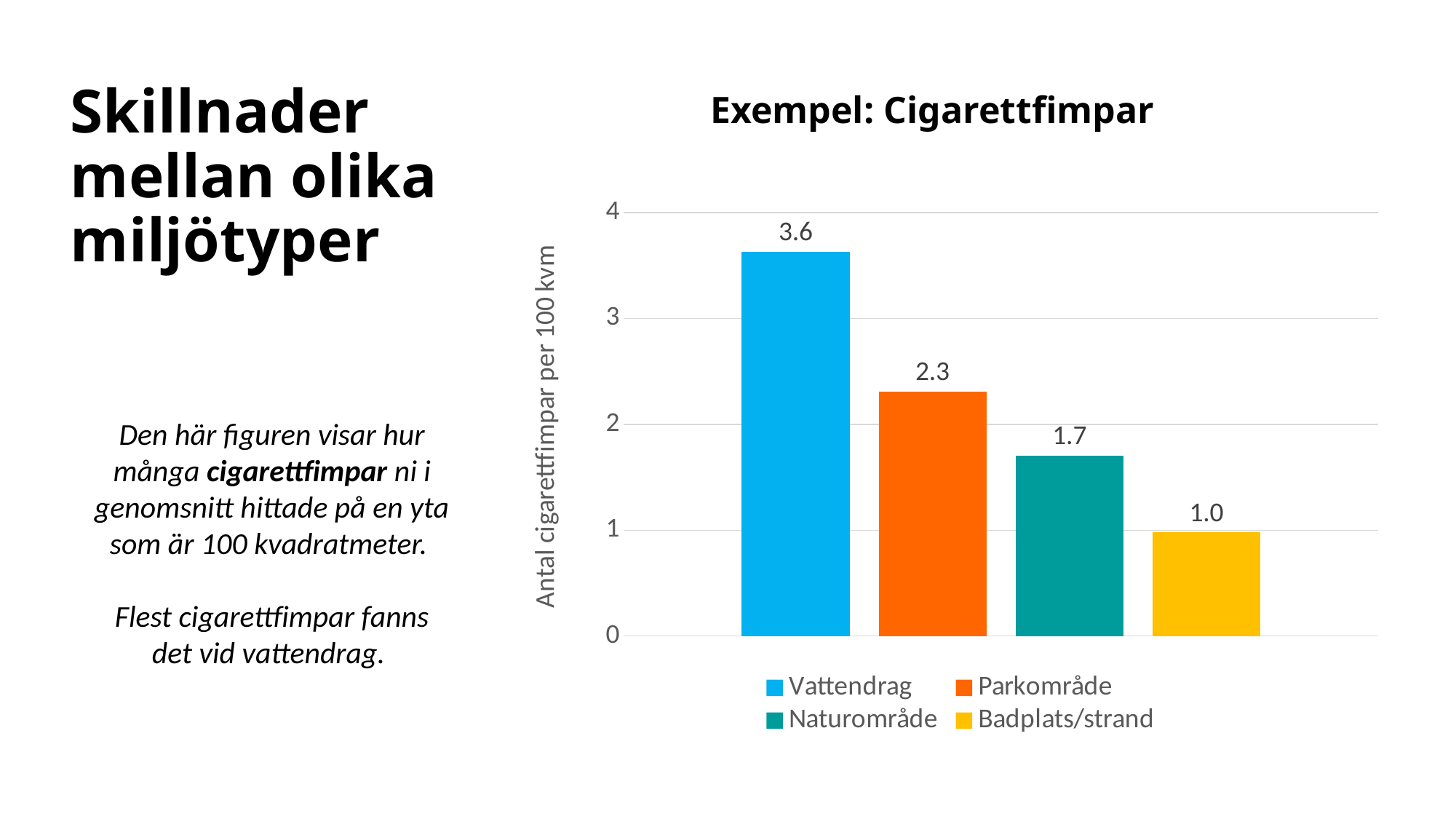
What is the title of the chart? Exempel: Cigarettfimpar What is the difference between the values for Vattendrag and Parkområde? 1.3 How many categories are shown in the chart? 4 What is the value for Naturområde? 1.7 What is the value for Parkområde? 2.3 Which category has the lowest value? Badplats/strand Which is larger, the value for Naturområde or the value for Badplats/strand? Naturområde Is the value for Parkområde greater or less than 2? greater What kind of chart is shown on the slide? Bar chart What is the value for Badplats/strand? 1.0 What is the value for Vattendrag? 3.6 Which category has the highest value? Vattendrag